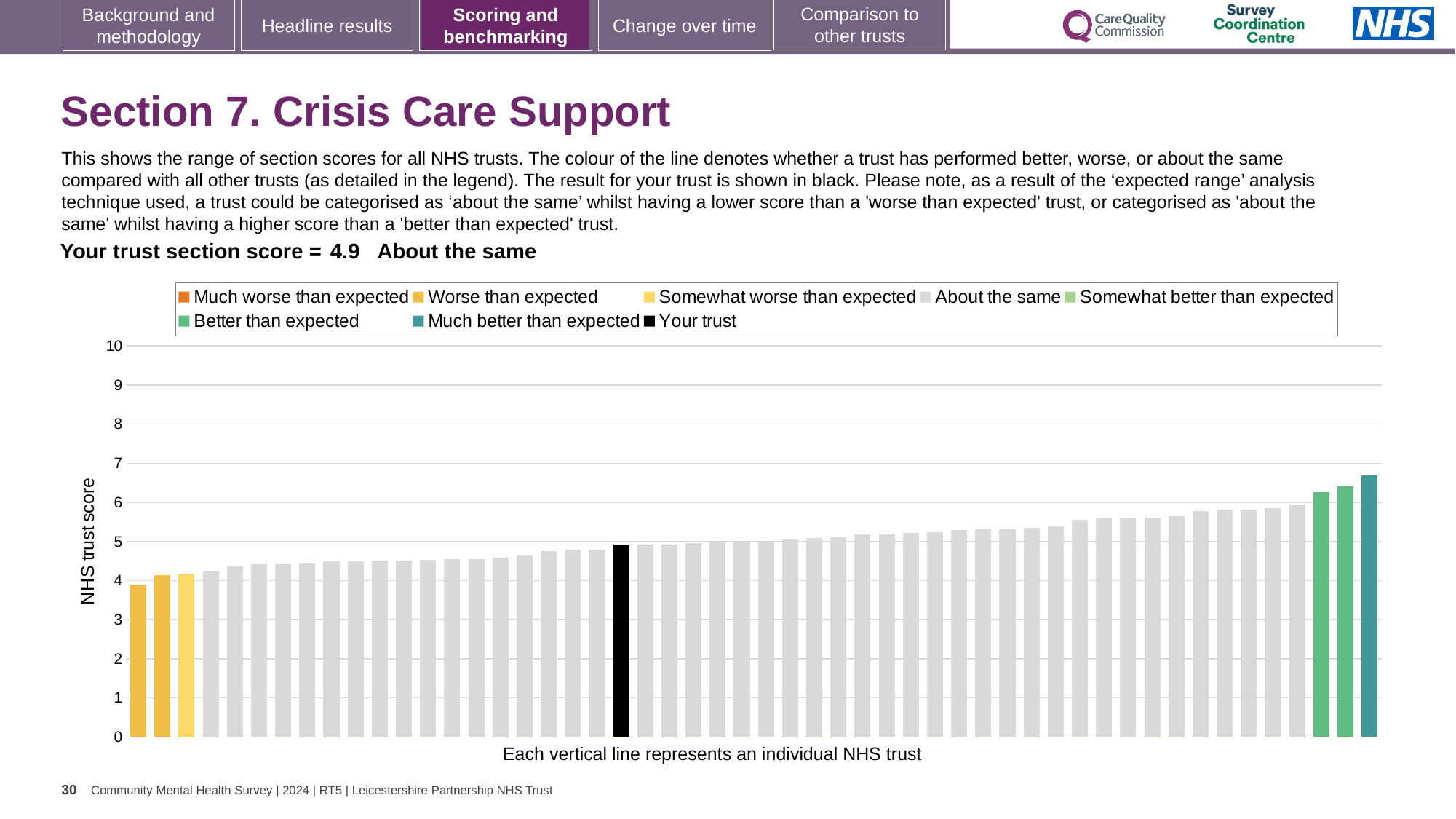
Is the value of the leftmost (lowest) bar greater or less than 3? greater Which performance category is your trust placed in for Crisis Care Support? About the same Is the value of the tallest bar in the chart greater or less than 6? greater What kind of chart is shown on the slide? Bar chart How many bars are coloured as 'Much better than expected' (teal)? 1 What is the label on the vertical axis of the chart? NHS trust score Do the bar values rise or fall moving from left to right along the x axis? Rise Is the value of the tallest bar in the chart greater or less than 7? less Which legend category does the tallest bar belong to? Much better than expected What is the section score for your trust shown on the slide? 4.9 How many entries does the chart legend list? 8